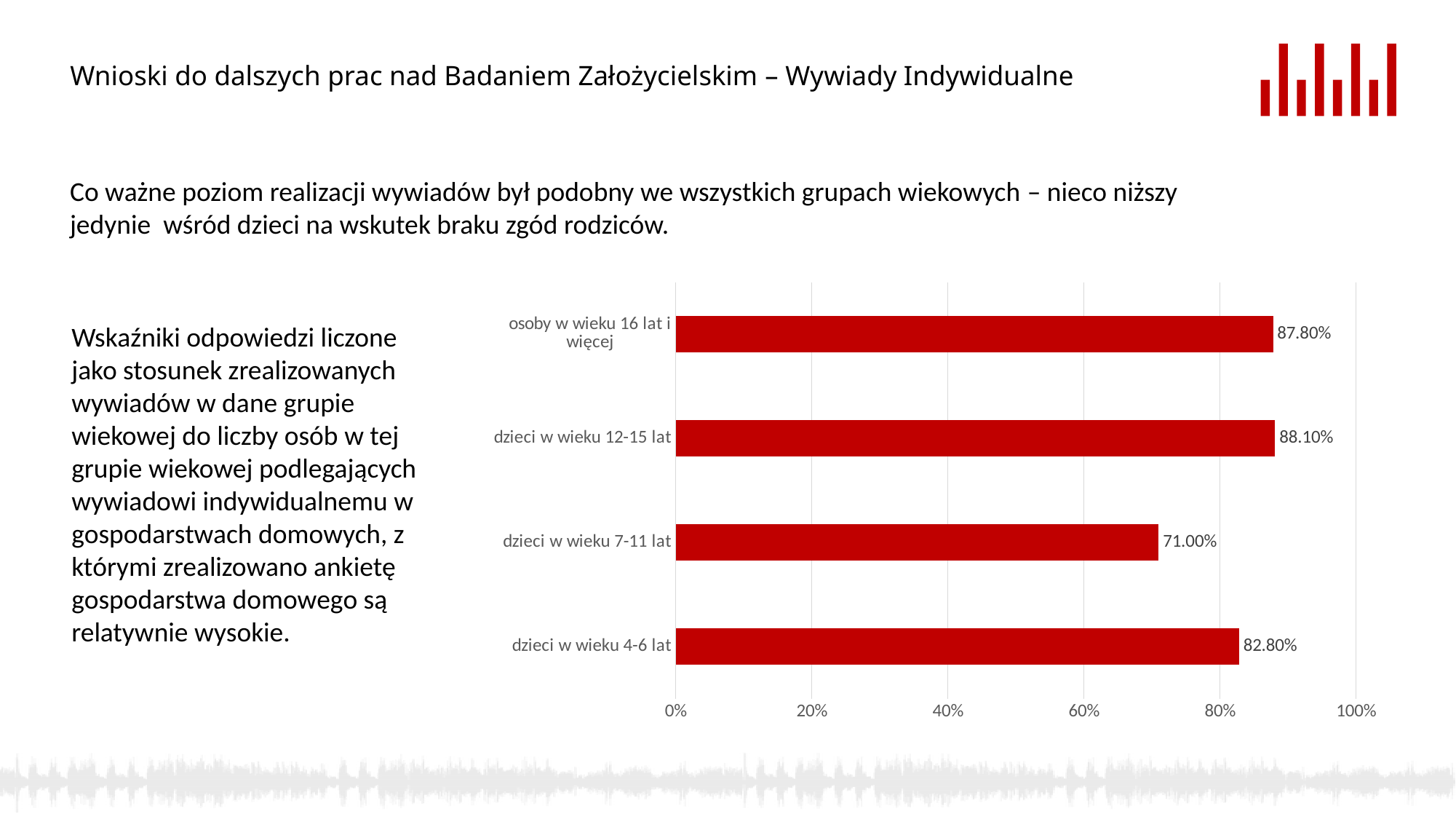
What is the value for "dzieci w wieku 12-15 lat"? 88.10% Is the value for "dzieci w wieku 7-11 lat" greater or less than 80%? less How many categories are shown in the chart? 4 What kind of chart is shown on the slide? bar chart What is the value for "osoby w wieku 16 lat i więcej"? 87.80% What is the highest value shown on the x axis of the chart? 100% What is the difference between the values for "dzieci w wieku 12-15 lat" and "dzieci w wieku 7-11 lat"? 17.10% What is the value for "dzieci w wieku 4-6 lat"? 82.80% Which is larger: the value for "dzieci w wieku 4-6 lat" or "dzieci w wieku 7-11 lat"? dzieci w wieku 4-6 lat Which category has the lowest value? dzieci w wieku 7-11 lat What is the value for "dzieci w wieku 7-11 lat"? 71.00% What is the difference between the values for "osoby w wieku 16 lat i więcej" and "dzieci w wieku 4-6 lat"? 5.00%